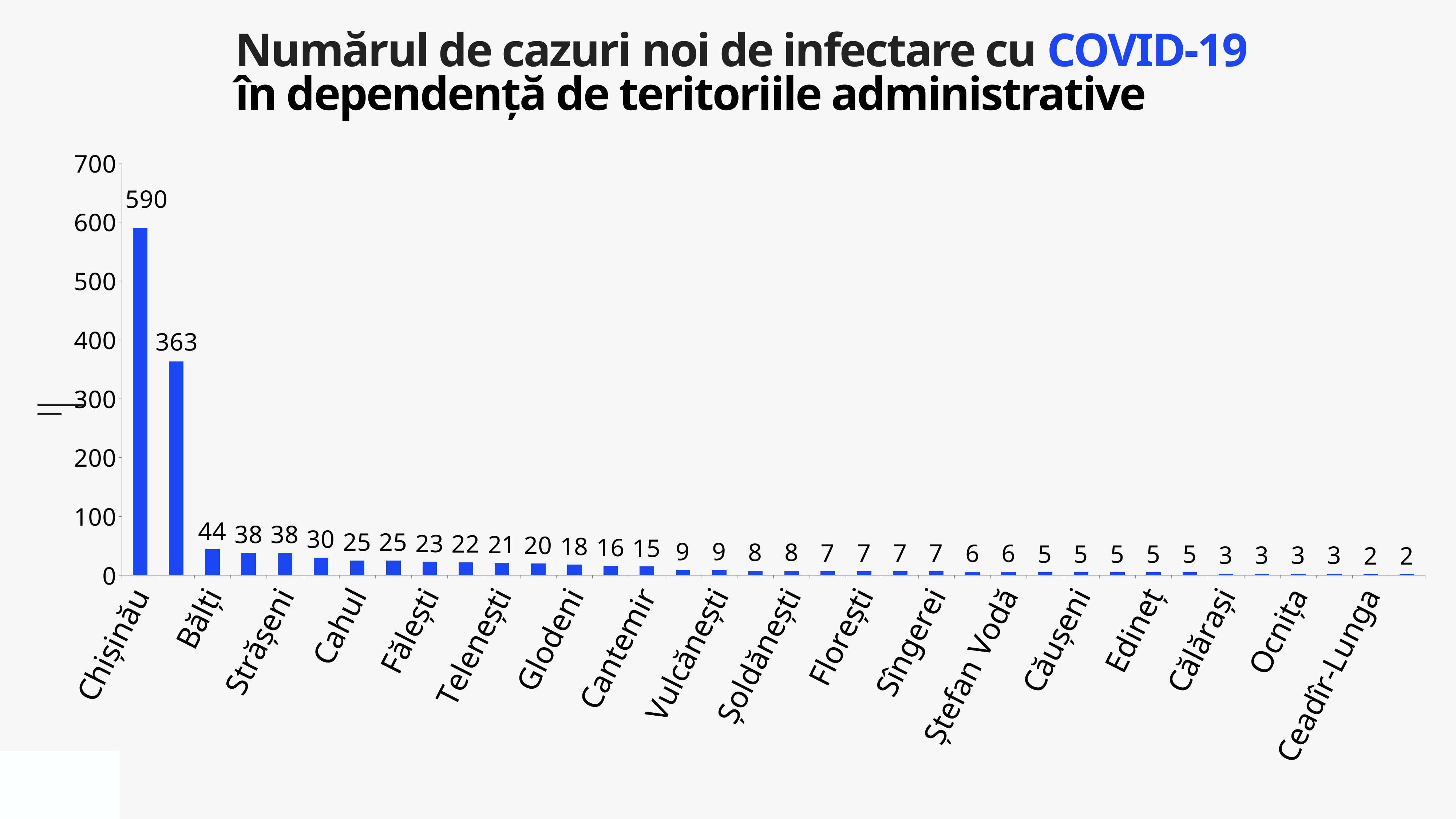
Is the value for Chișinău greater or less than 500? greater What is the highest tick value on the vertical axis? 700 What is the second-highest value shown on the chart? 363 Which administrative territory has the highest number of new COVID-19 cases? Chișinău How many category labels are shown on the x axis? 18 What is the number of new cases for Chișinău? 590 Do the values rise or fall from left to right along the x axis? fall What is the highest value shown on the chart? 590 What is the difference between the two highest values on the chart (590 and 363)? 227 What kind of chart is shown on the slide? bar chart What is the lowest value shown on the chart? 2 How many bars have a value greater than 100? 2